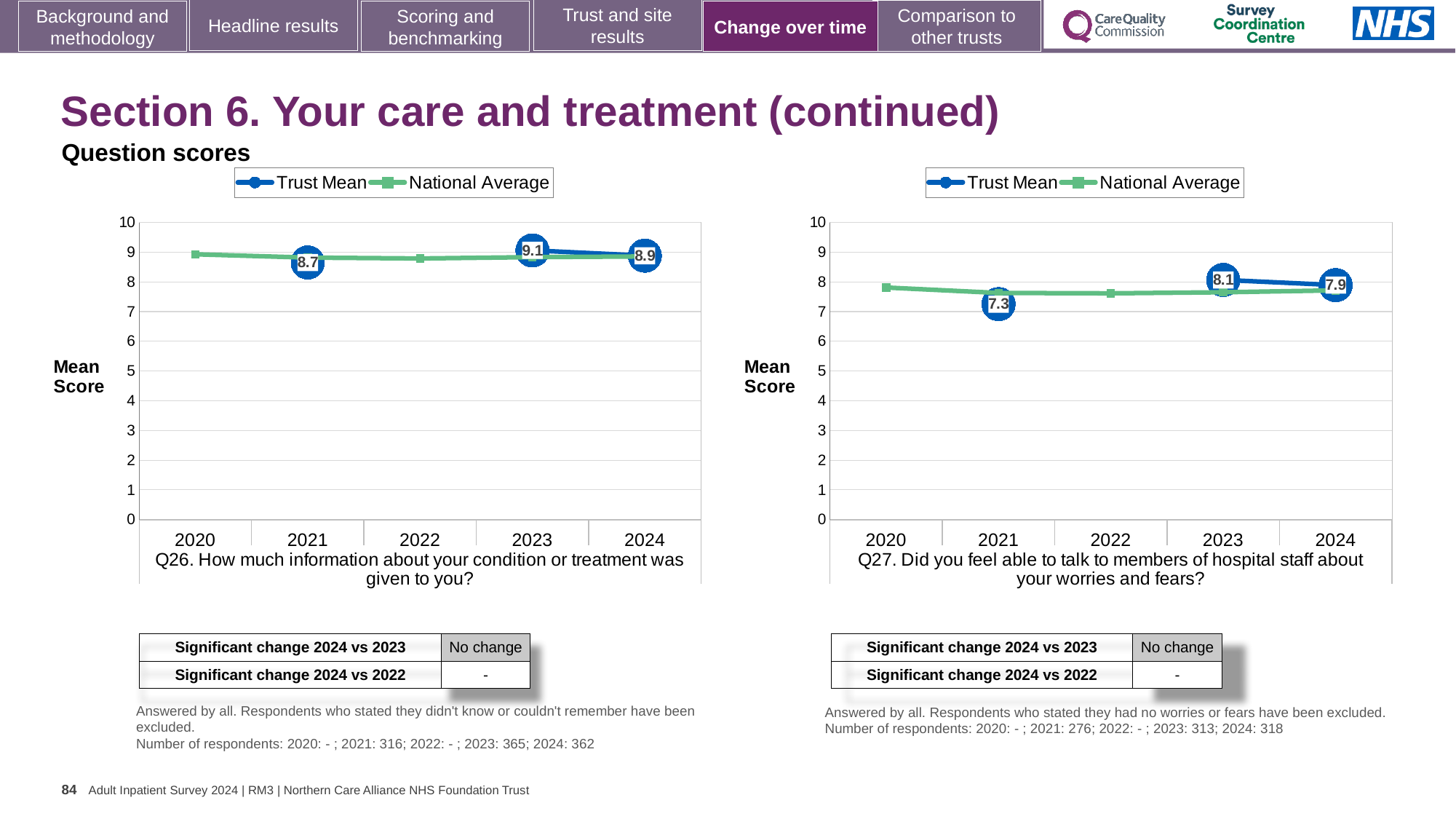
In the Q26 chart (left), what is the difference between the Trust Mean scores for 2023 and 2021? 0.4 In the Q27 chart (right), is the National Average for 2020 greater or less than 7? greater In the Q27 chart (right), what is the difference between the Trust Mean scores for 2023 and 2021? 0.8 In the Q26 chart (left), what is the Trust Mean score for 2021? 8.7 In the Q27 chart (right), which year has the highest labelled Trust Mean score? 2023 In the Q27 chart (right), what is the Trust Mean score for 2021? 7.3 How many series does the legend of the Q26 chart (left) list? 2 In the Q27 chart (right), which year has the lowest labelled Trust Mean score? 2021 What kind of chart is the Q27 chart (right)? Line chart In the Q27 chart (right), what is the Trust Mean score for 2024? 7.9 In the Q26 chart (left), what is the Trust Mean score for 2024? 8.9 In the Q26 chart (left), what is the Trust Mean score for 2023? 9.1